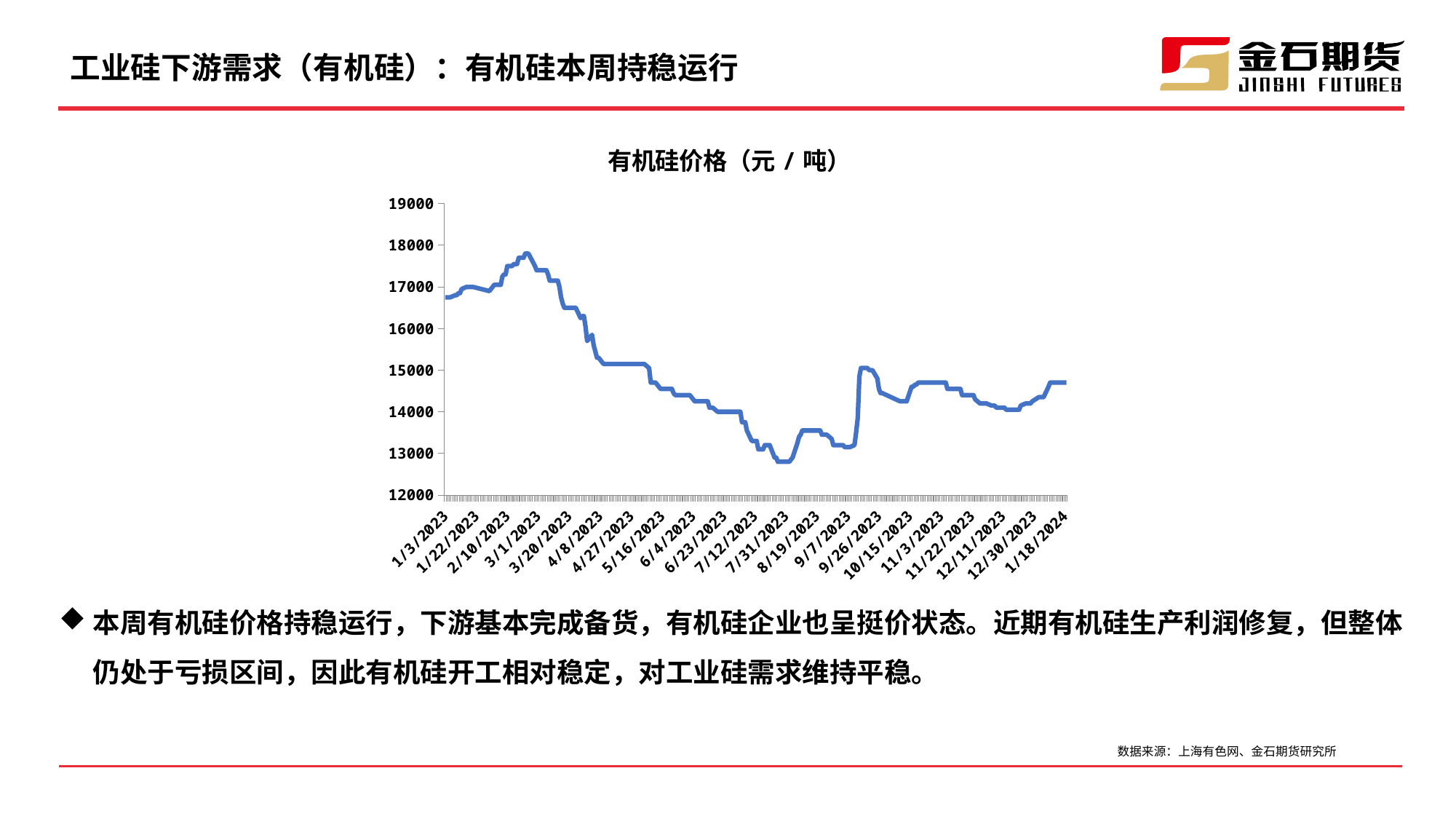
How many data series are plotted in the chart? 1 Around which x-axis date does the line reach its lowest point? 7/31/2023 What is the title of the chart? 有机硅价格（元／吨） Is the value at 1/18/2024 greater or less than 14000? greater Is the value at 1/3/2023 greater or less than 16000? greater What kind of chart is shown on the slide? line chart Is the value at 3/1/2023 greater or less than 17000? greater Is the value at 1/3/2023 larger or smaller than the value at 1/18/2024? larger Around which x-axis date does the line reach its highest point? 3/1/2023 Overall, does the line rise or fall from the start of the x axis to the end? fall